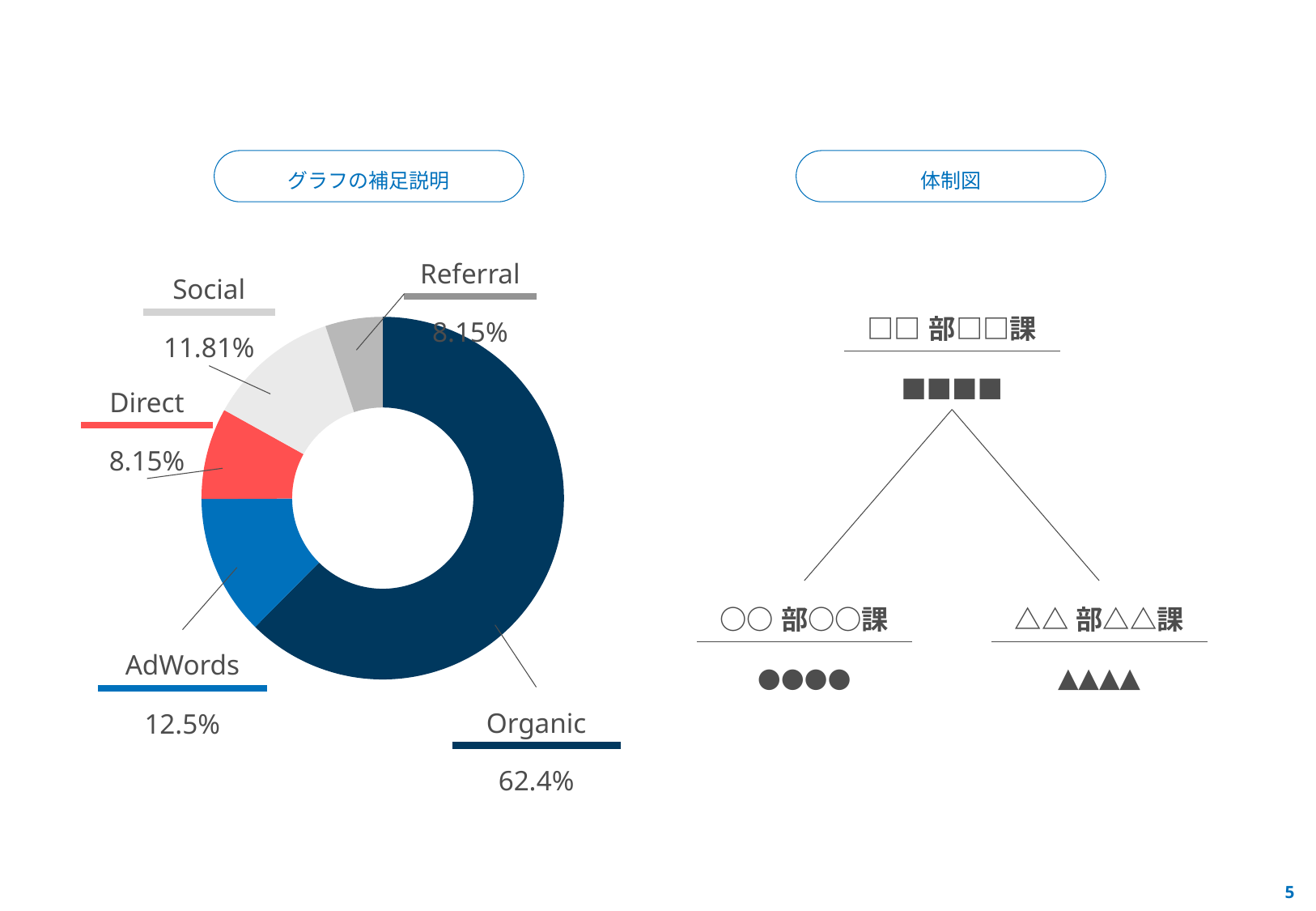
Which category has the largest share in the pie chart? Organic What colour is the Direct slice in the pie chart? red What percentage is labelled for Social in the pie chart? 11.81% What is the difference between the Social and Direct percentages in the pie chart? 3.66% What is the difference between the Organic and AdWords percentages in the pie chart? 49.9% What kind of chart is shown on the left of the slide? doughnut chart How many categories are shown in the pie chart? 5 What value is shown for Direct in the pie chart? 8.15% Which is larger in the pie chart, AdWords or Social? AdWords What is the value shown for AdWords in the pie chart? 12.5% What percentage does the Organic slice represent in the pie chart? 62.4% What value is shown for Referral in the pie chart? 8.15%